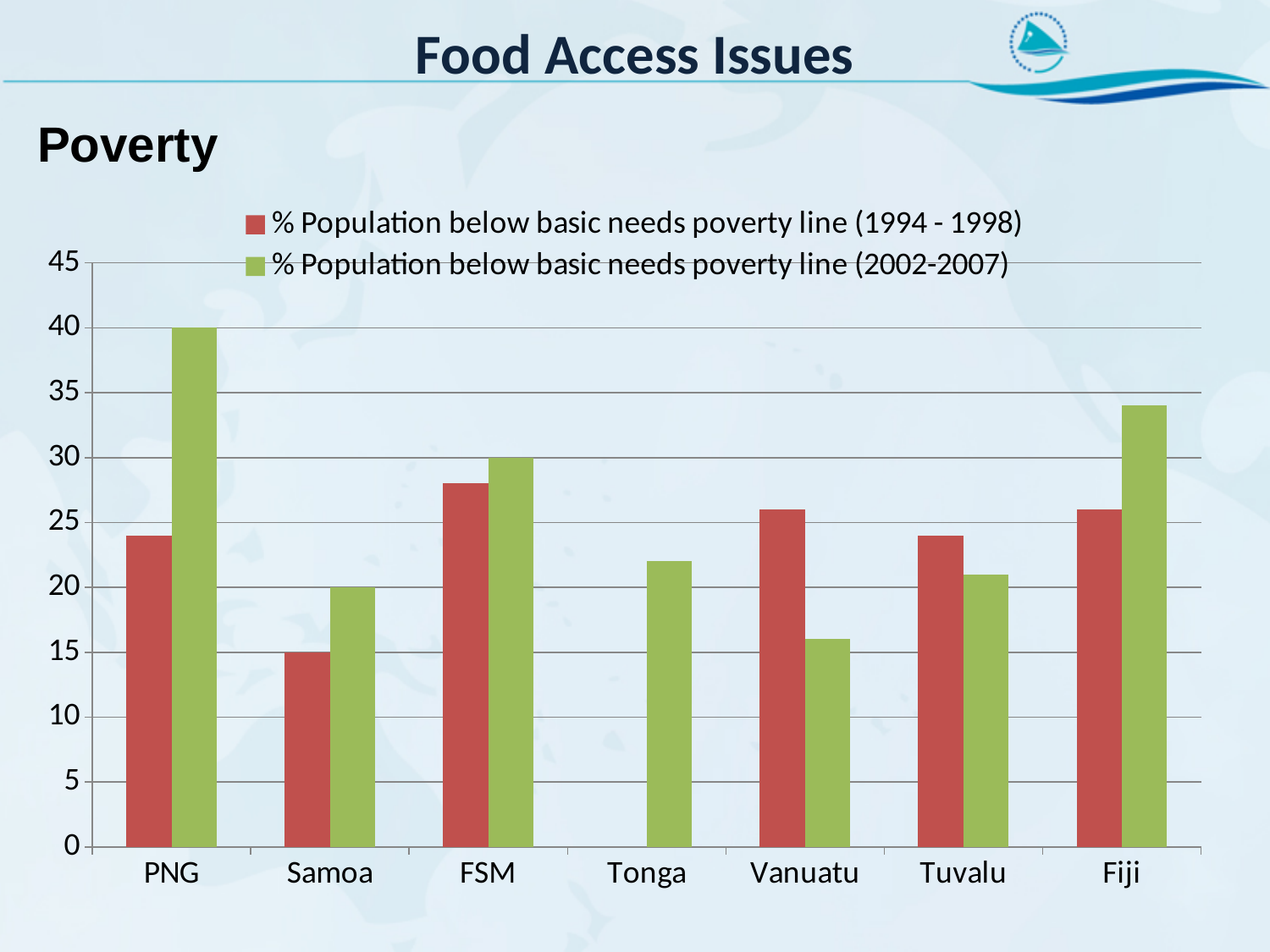
What is the value for Samoa in the % Population below basic needs poverty line (1994 - 1998) series? 15 What is the value for FSM in the % Population below basic needs poverty line (2002-2007) series? 30 How many series does the legend list? 2 What is the value for PNG in the % Population below basic needs poverty line (2002-2007) series? 40 How many countries are shown on the x axis? 7 For Vanuatu, which series has the larger value: 1994 - 1998 or 2002-2007? 1994 - 1998 Which country has the lowest value in the % Population below basic needs poverty line (1994 - 1998) series? Samoa Is the value for Vanuatu in the 2002-2007 series greater or less than 20? less What kind of chart is shown on the slide? Bar chart Is the value for Fiji in the 2002-2007 series greater or less than 30? greater What is the difference between the 2002-2007 values for PNG and Samoa? 20 Which country has the highest value in the % Population below basic needs poverty line (2002-2007) series? PNG